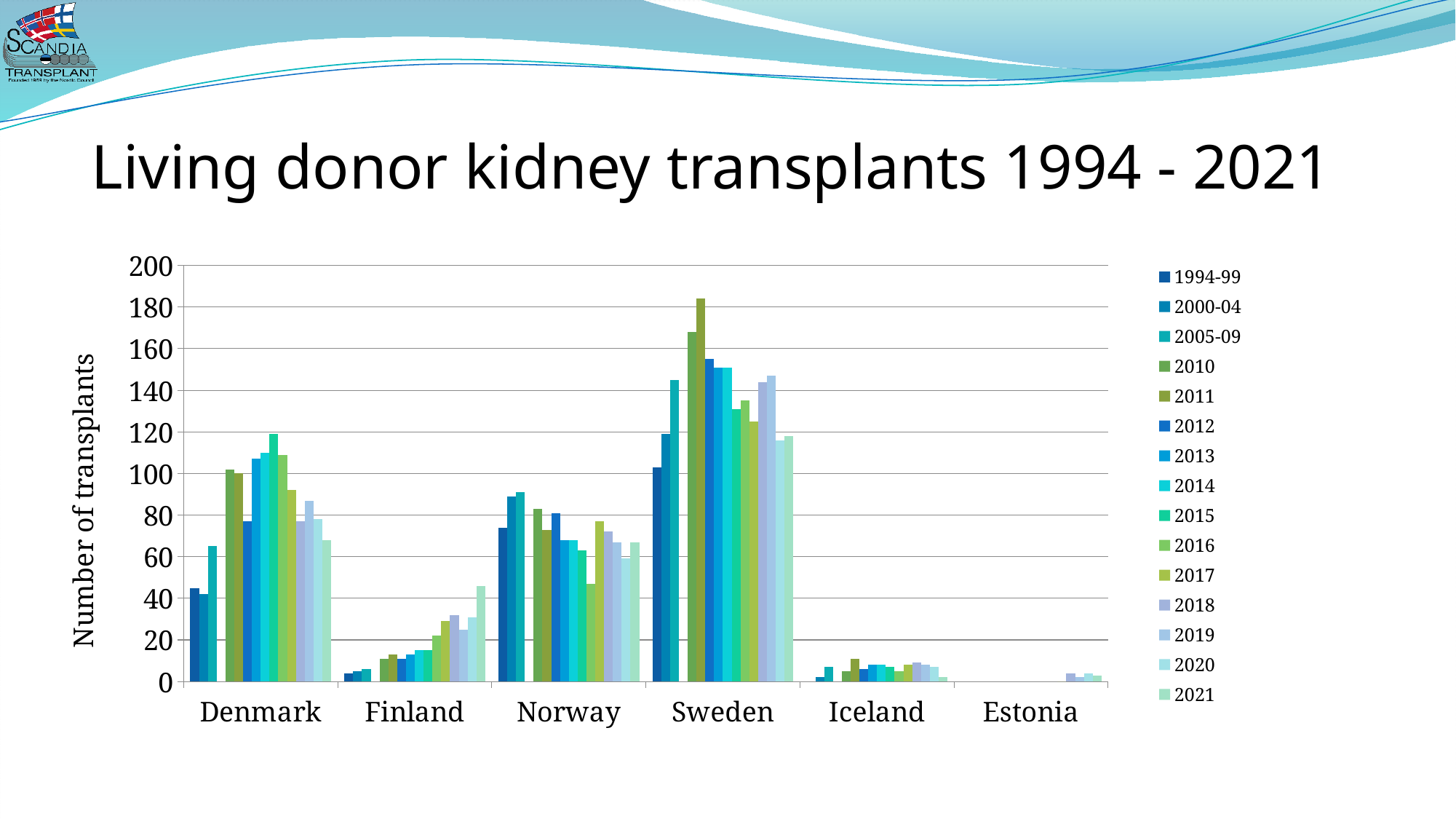
Do the values for Finland rise or fall from 1994-99 to 2021? rise Which country has the lowest number of living donor kidney transplants in the chart? Estonia Which country has the highest number of living donor kidney transplants in the chart? Sweden What is the label of the y axis? Number of transplants Is the value for Finland in 2021 greater or less than 40? greater How many series does the legend list? 15 What kind of chart is shown on the slide? bar chart How many countries are shown on the x axis of the chart? 6 Which is larger, the value for Norway in 2005-09 or the value for Denmark in 2005-09? Norway in 2005-09 Is the value for Sweden in 2011 greater or less than 180? greater Is the value for Norway in 1994-99 greater or less than 80? less